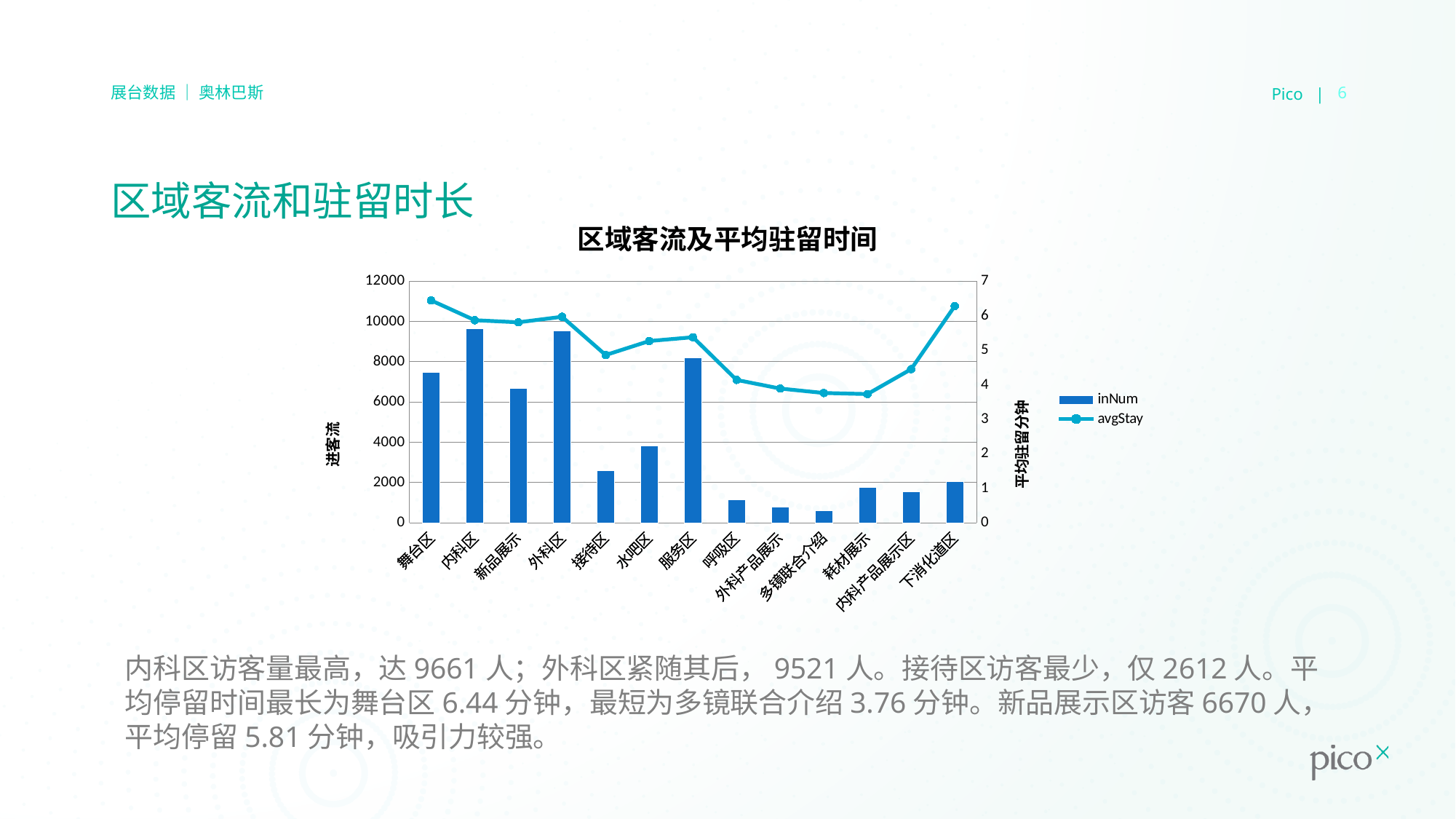
What type of chart is shown on the slide? Combined bar and line chart How many categories are shown on the x axis? 13 Which has a larger inNum value, 舞台区 or 新品展示? 舞台区 What is the difference in inNum between 内科区 and 外科区? 140 How many series does the legend list? 2 Which category has the highest avgStay value? 舞台区 What is the inNum value for 内科区? 9661 Is the avgStay value for 接待区 greater or less than 4? greater Which category has the highest inNum value? 内科区 What is the avgStay value for 多镜联合介绍? 3.76 What is the inNum value for 外科区? 9521 Is the inNum value for 舞台区 greater or less than 6000? greater